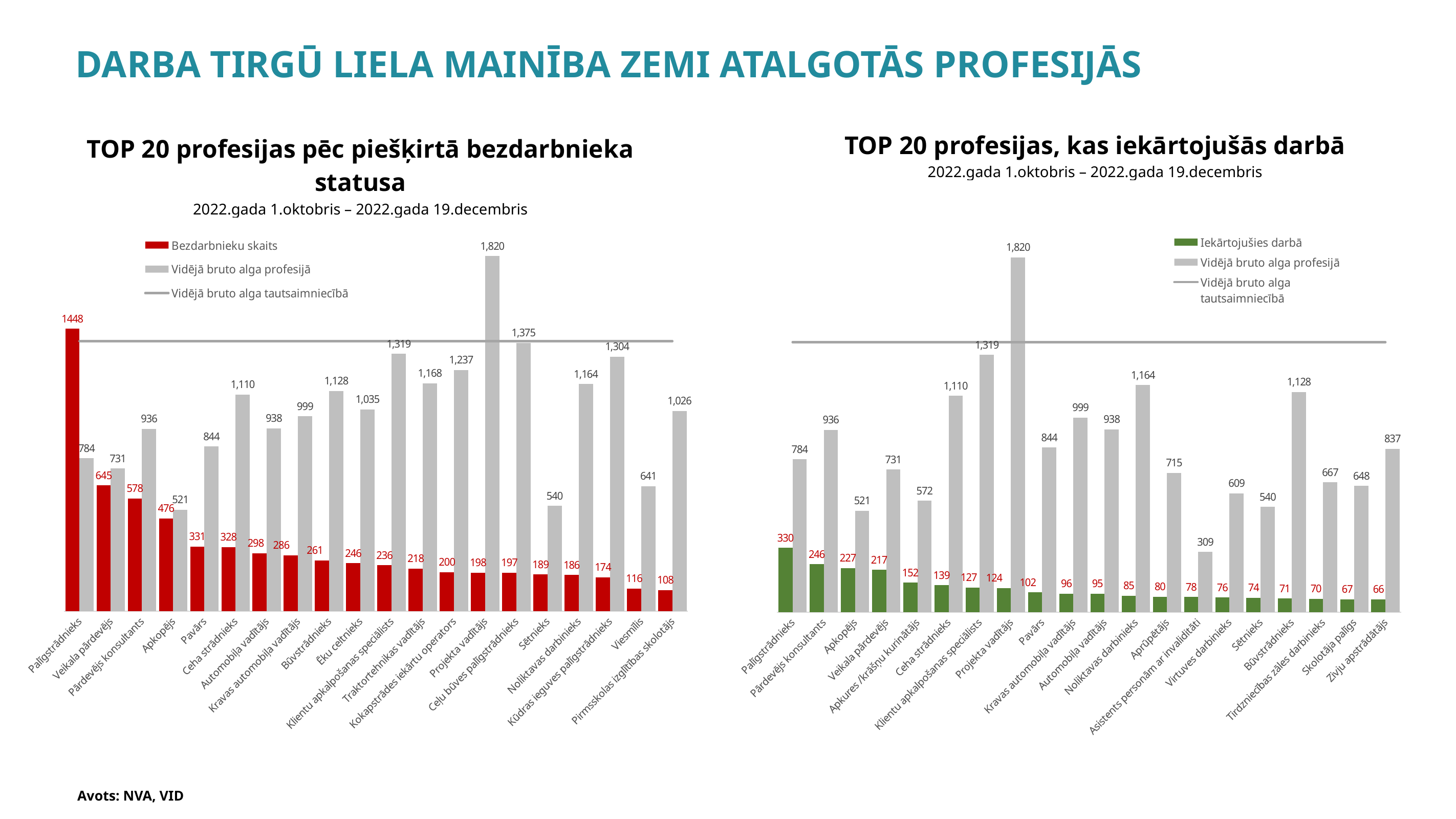
In the left chart (TOP 20 profesijas pēc piešķirtā bezdarbnieka statusa), what is the Vidējā bruto alga profesijā for Projekta vadītājs? 1,820 In the left chart (TOP 20 profesijas pēc piešķirtā bezdarbnieka statusa), what is the Bezdarbnieku skaits value for Palīgstrādnieks? 1448 What type of chart is the left chart (TOP 20 profesijas pēc piešķirtā bezdarbnieka statusa)? Combination bar and line chart In the right chart (TOP 20 profesijas, kas iekārtojušās darbā), which profession has the lowest Vidējā bruto alga profesijā? Asistents personām ar invaliditāti In the left chart (TOP 20 profesijas pēc piešķirtā bezdarbnieka statusa), what is the difference between the Bezdarbnieku skaits for Veikala pārdevējs and Pārdevējs konsultants? 67 In the right chart (TOP 20 profesijas, kas iekārtojušās darbā), which profession has the highest Iekārtojušies darbā value? Palīgstrādnieks In the right chart (TOP 20 profesijas, kas iekārtojušās darbā), how many professions are shown on the x axis? 20 In the right chart (TOP 20 profesijas, kas iekārtojušās darbā), which is larger: the Vidējā bruto alga profesijā for Aprūpētājs or for Virtuves darbinieks? Aprūpētājs In the left chart (TOP 20 profesijas pēc piešķirtā bezdarbnieka statusa), how many series does the legend list? 3 In the left chart (TOP 20 profesijas pēc piešķirtā bezdarbnieka statusa), which profession has the lowest Bezdarbnieku skaits? Pirmsskolas izglītības skolotājs In the right chart (TOP 20 profesijas, kas iekārtojušās darbā), what is the Iekārtojušies darbā value for Apkopējs? 227 In the right chart (TOP 20 profesijas, kas iekārtojušās darbā), what is the difference between the Iekārtojušies darbā values for Palīgstrādnieks and Pārdevējs konsultants? 84